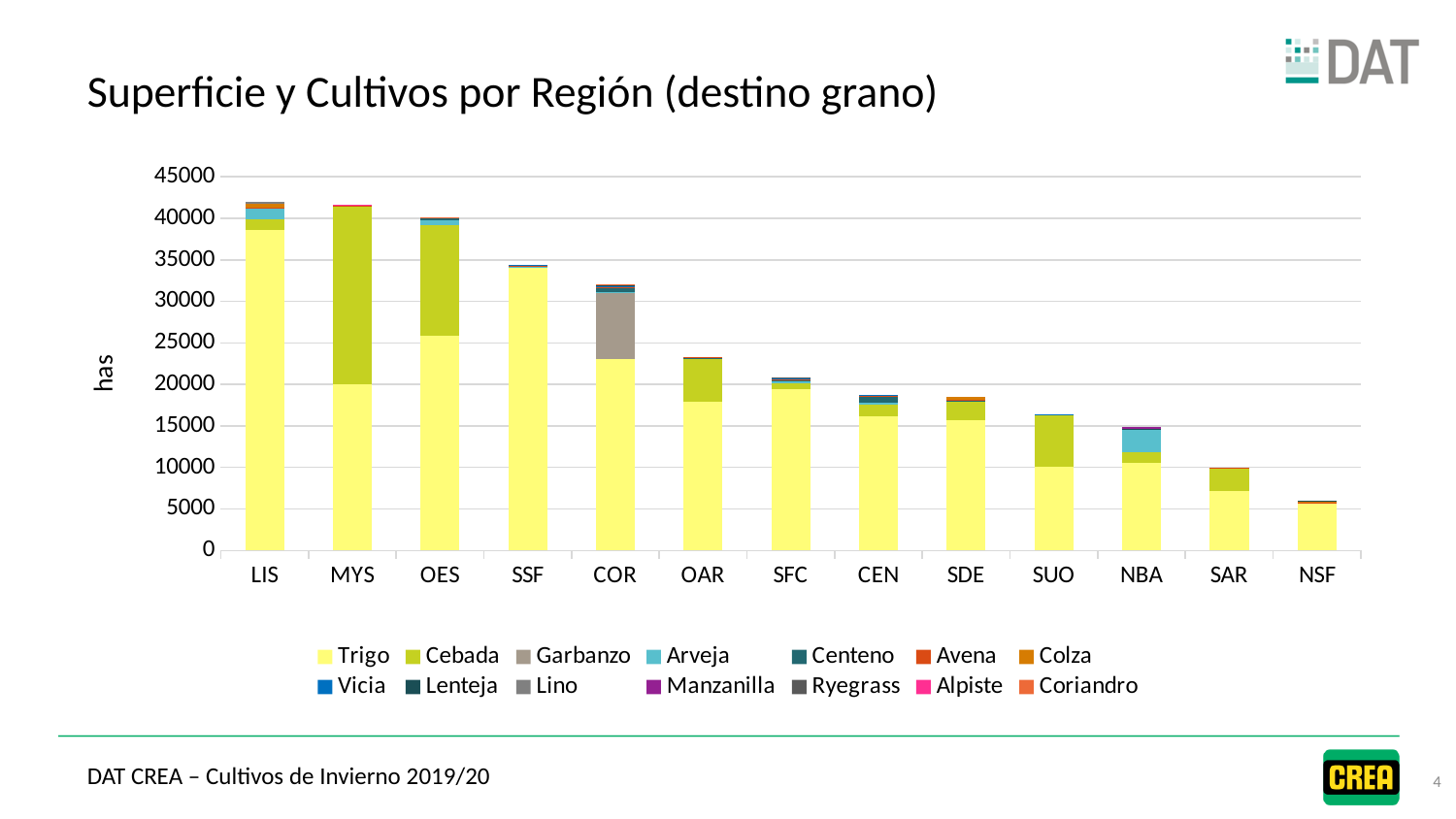
Which region has the lowest total bar in the chart? NSF How many regions are shown along the x axis of the chart? 13 Is the total bar for NSF greater or less than 10000? less Which region has a larger total bar, SSF or COR? SSF Which region has a larger total bar, SUO or SAR? SUO Is the total bar for LIS greater or less than 40000? greater Is the total bar for CEN greater or less than 20000? less What is the label on the y axis of the chart? has Do the total bar heights generally rise or fall from left to right across the regions? fall How many crop series does the legend list? 14 What kind of chart is shown on the slide? Stacked bar chart